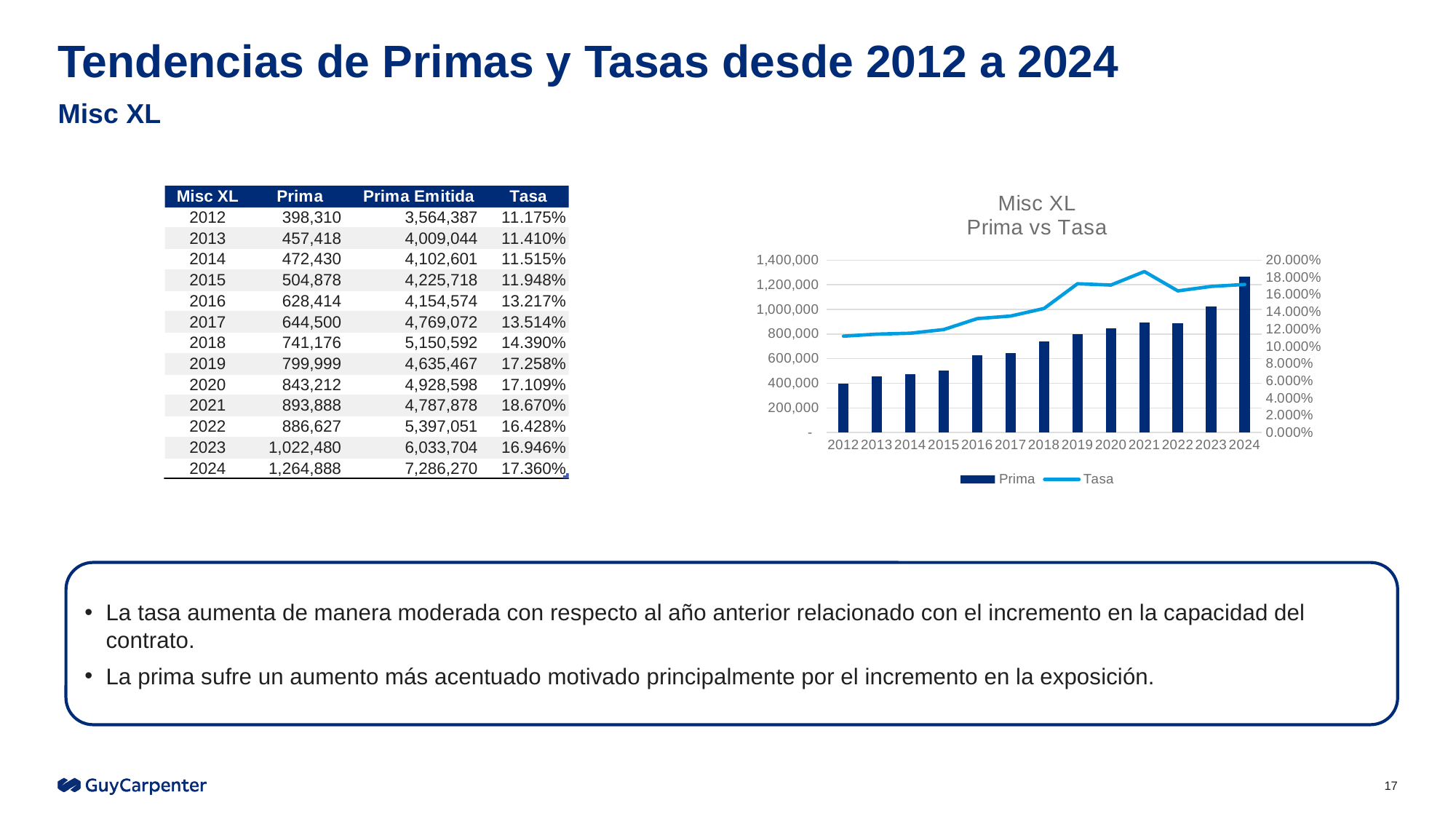
In the 'Misc XL Prima vs Tasa' chart, which year has the highest Prima? 2024 How many series does the legend of the 'Misc XL Prima vs Tasa' chart list? 2 What is the Tasa value for 2021 shown on the slide? 18.670% What is the difference between the Prima for 2024 and the Prima for 2012? 866,578 What kind of chart is the 'Misc XL Prima vs Tasa' chart? A combined bar and line chart What is the Prima value for 2024 shown on the slide? 1,264,888 In the 'Misc XL Prima vs Tasa' chart, which year has the highest Tasa? 2021 In the 'Misc XL Prima vs Tasa' chart, is the Prima value for 2018 greater or less than 800,000? less In the 'Misc XL Prima vs Tasa' chart, is the Prima value for 2023 greater or less than 1,000,000? greater In the 'Misc XL Prima vs Tasa' chart, does the Prima series generally rise or fall from 2012 to 2024? rise How many years are plotted on the x axis of the 'Misc XL Prima vs Tasa' chart? 13 In the 'Misc XL Prima vs Tasa' chart, which year has the lowest Prima? 2012